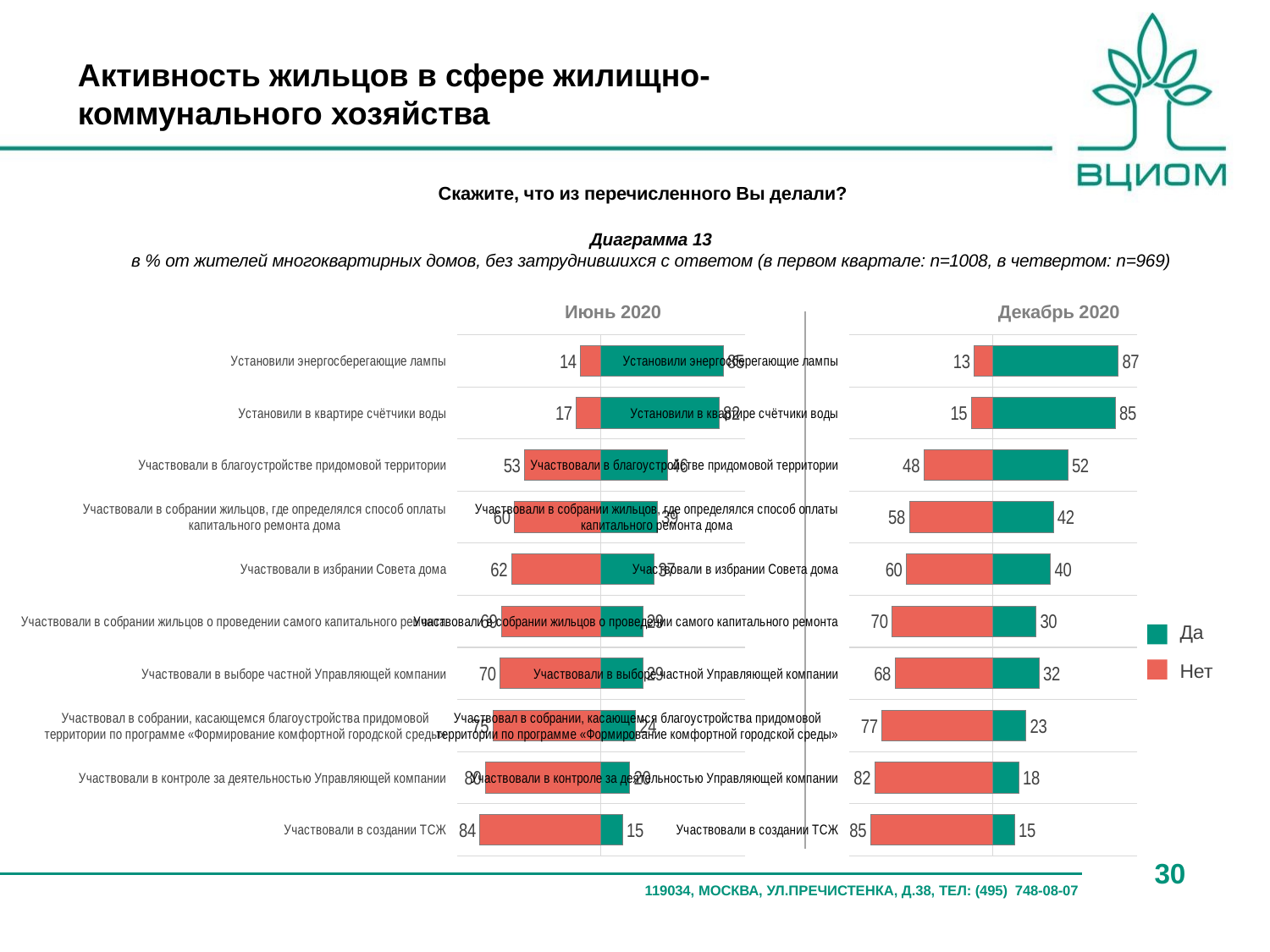
In the Декабрь 2020 chart, what is the Нет value for Участвовали в благоустройстве придомовой территории? 48 In the Декабрь 2020 chart, what is the Да value for Установили энергосберегающие лампы? 87 In the Июнь 2020 chart, what is the Да value for Участвовали в создании ТСЖ? 15 What type of chart is the Декабрь 2020 chart? bar chart In the Июнь 2020 chart, what is the Нет value for Участвовали в избрании Совета дома? 62 In the Декабрь 2020 chart, which is larger for Участвовали в благоустройстве придомовой территории: Да or Нет? Да In the Декабрь 2020 chart, which category has the lowest Да value? Участвовали в создании ТСЖ Which colour represents the Нет series in the legend? red How many series does the legend list? 2 How many categories are shown in the Июнь 2020 chart? 10 In the Декабрь 2020 chart, what is the difference between the Да and Нет values for Участвовали в выборе частной Управляющей компании? 36 In the Декабрь 2020 chart, which category has the highest Да value? Установили энергосберегающие лампы